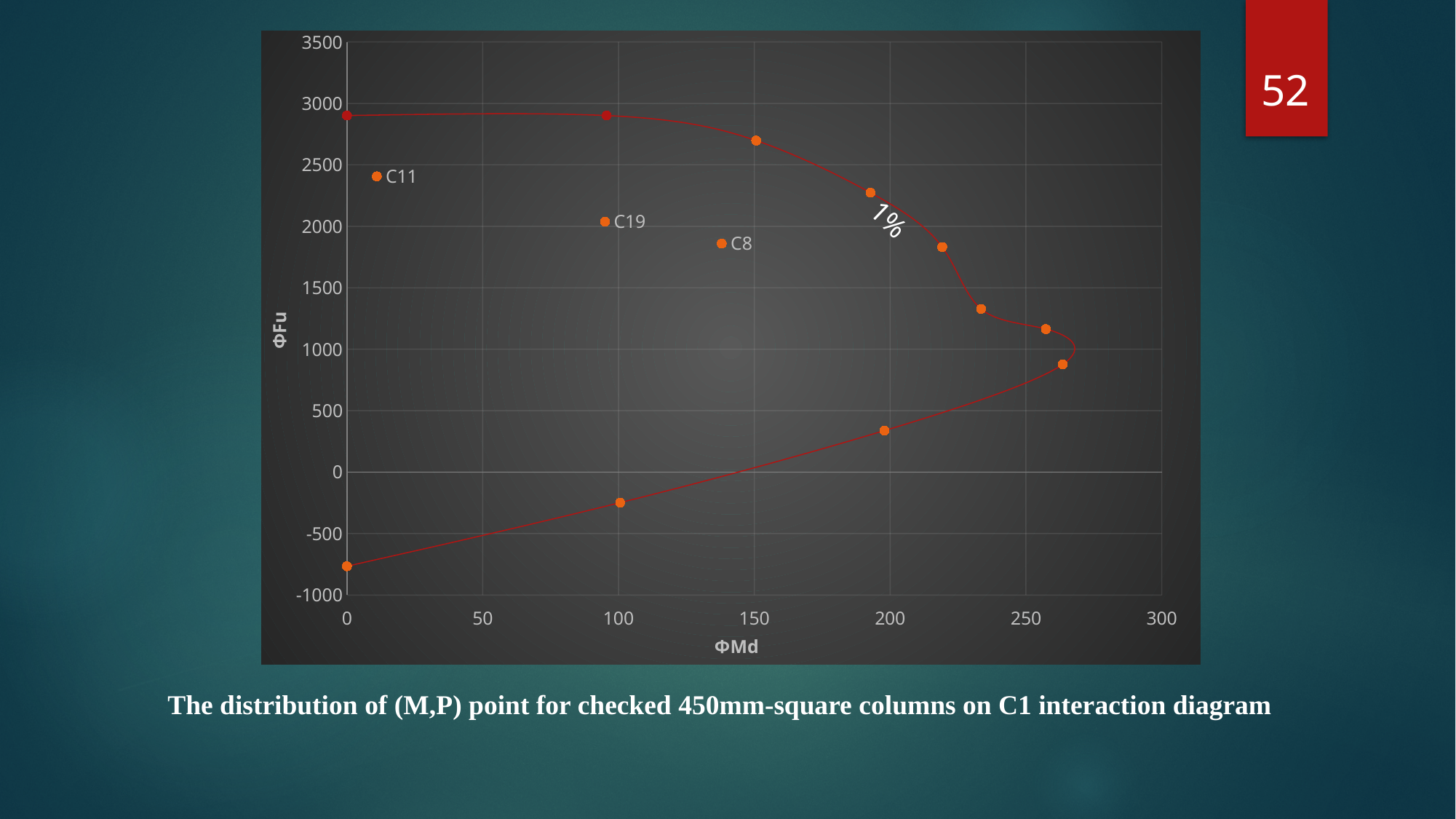
What kind of chart is shown on the slide? scatter chart Which labeled column point has the highest ΦFu value? C11 How many labeled column points (C-labels) are plotted inside the interaction diagram? 3 Which labeled column point has the lowest ΦFu value? C8 Is the ΦFu value for C8 greater or less than 2000? less Is the ΦFu value for C11 greater or less than 2000? greater Which has a higher ΦFu value, C11 or C8? C11 Is the ΦMd value for C8 greater or less than 100? greater What label is written on the red interaction curve? 1% Which labeled column point has the smallest ΦMd value? C11 Which labeled column point has the largest ΦMd value? C8